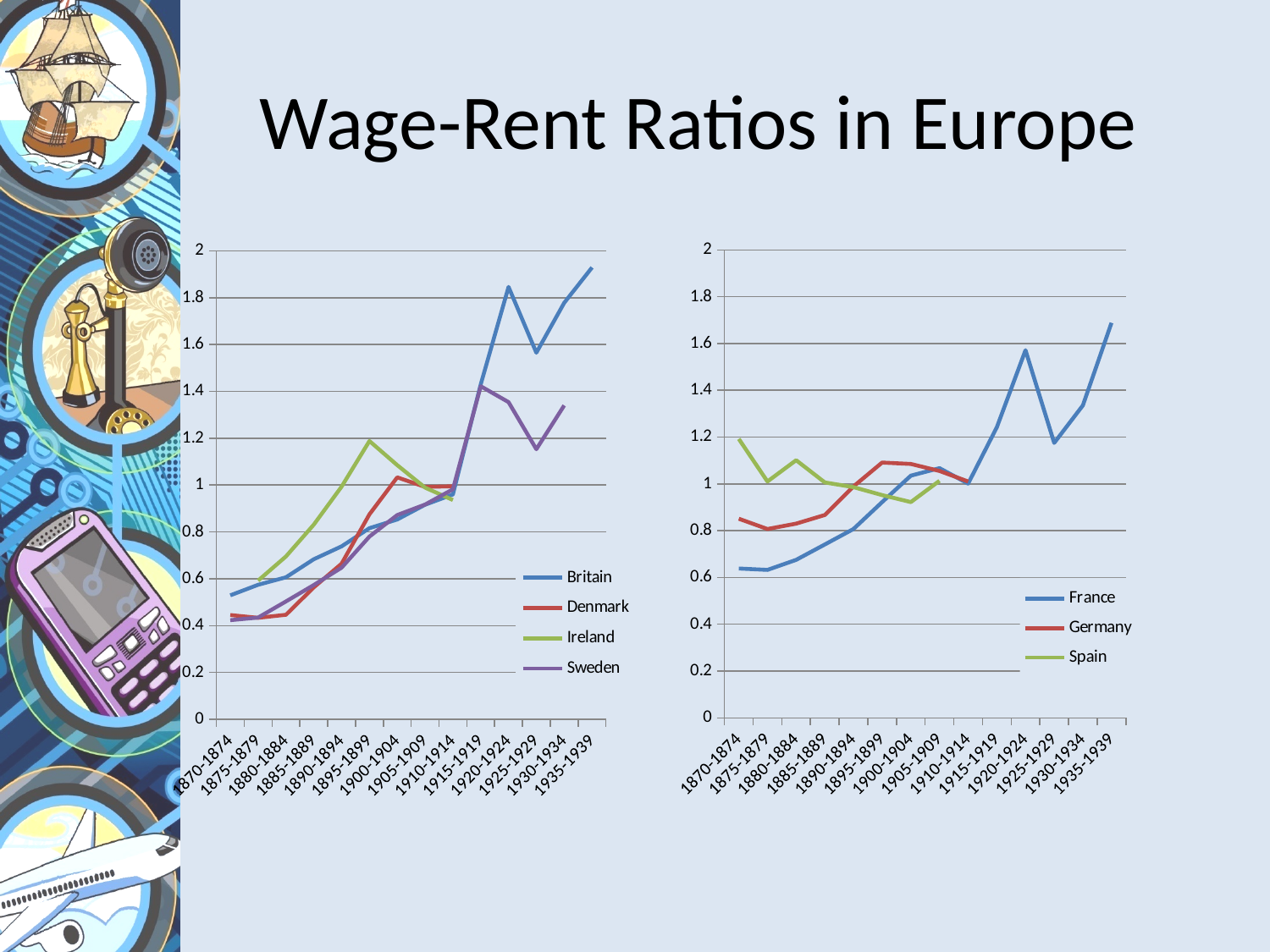
What kind of chart is the left chart on the slide? Line chart How many series does the legend of the right chart list? 3 In the right chart, does the value for France generally rise or fall from 1870-1874 to 1935-1939? Rise How many series does the legend of the left chart list? 4 What is the title of the slide? Wage-Rent Ratios in Europe In the left chart, is the value for Britain in 1935-1939 greater or less than 1.8? greater In the right chart, is the value for Spain in 1870-1874 greater or less than 1? greater In the right chart, is the value for France in 1935-1939 greater or less than 1.6? greater In the right chart, which series is higher in 1870-1874, France or Germany? Germany How many time periods are shown along the x axis of the right chart? 14